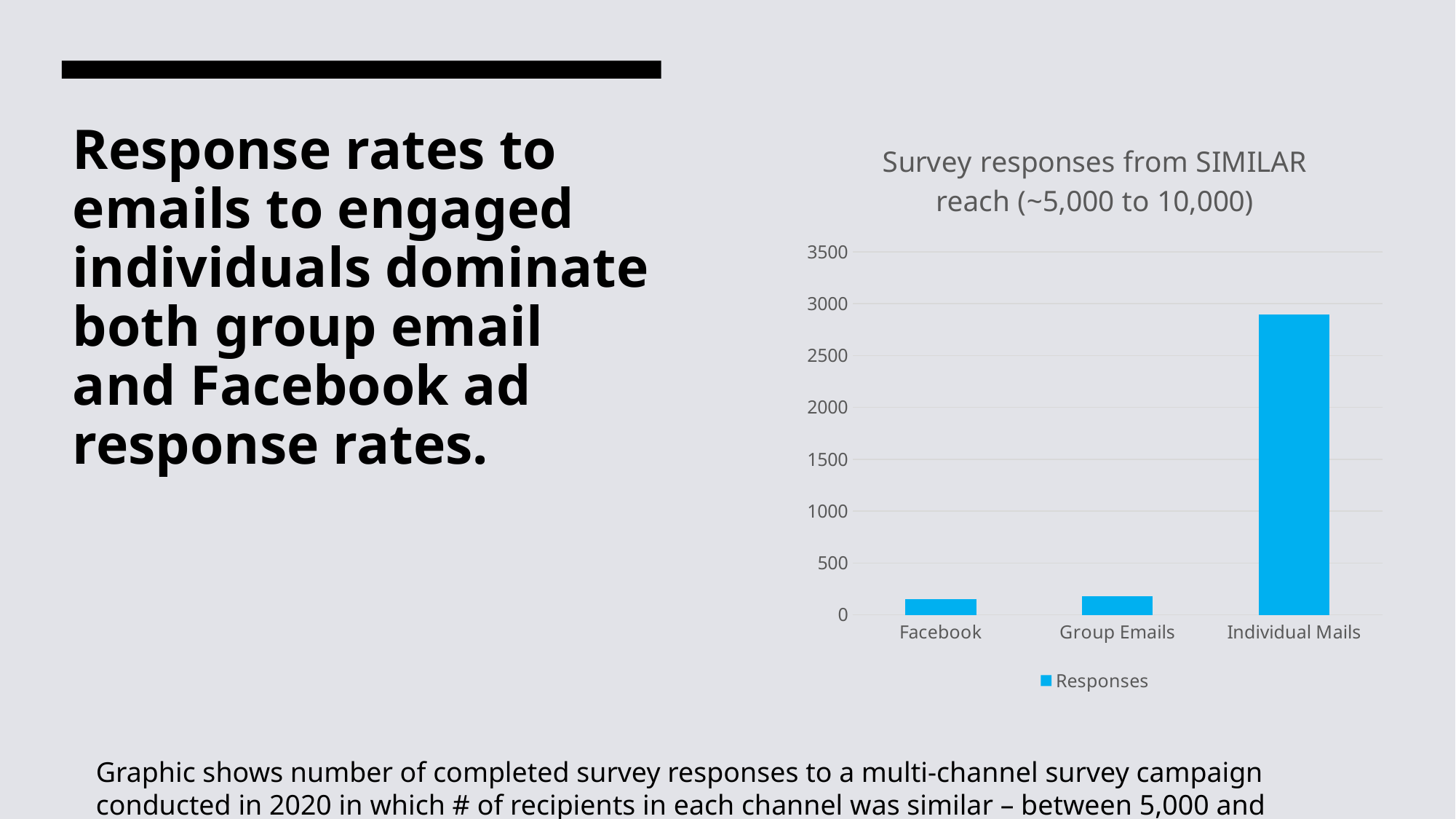
Is the value for Individual Mails greater or less than 2500? greater Which category has the highest number of responses? Individual Mails Is the value for Group Emails greater or less than 500? less Which is larger, the value for Individual Mails or the value for Facebook? Individual Mails Is the value for Facebook greater or less than 500? less How many series does the chart legend list? 1 What series name is shown in the chart legend? Responses How many categories are shown on the x axis of the chart? 3 Which is larger, the value for Group Emails or the value for Individual Mails? Individual Mails What type of chart is shown on the slide? bar chart What is the title of the chart? Survey responses from SIMILAR reach (~5,000 to 10,000)